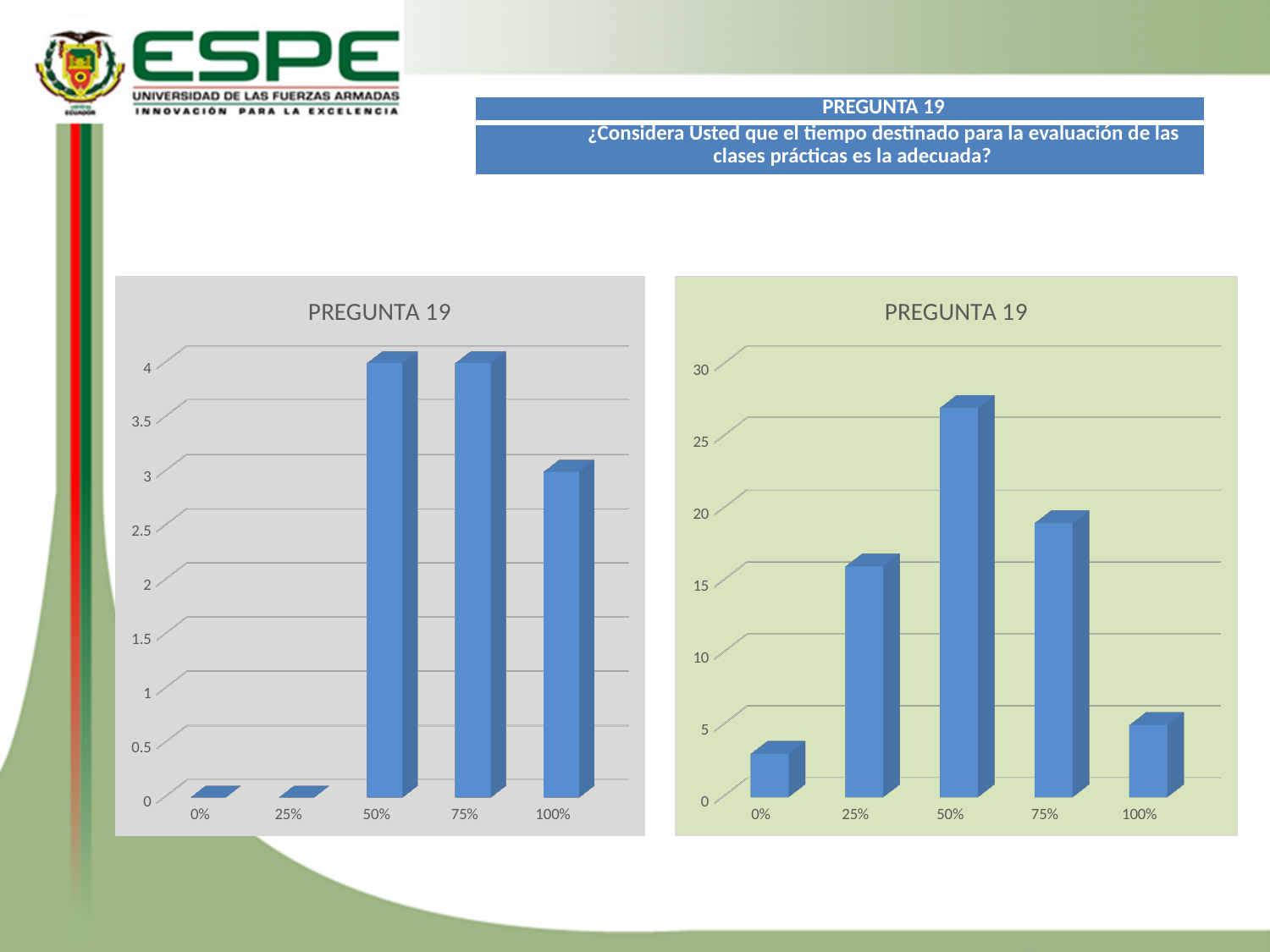
On the left chart, what is the value for 50%? 4 How many categories are shown on the x axis of the right chart? 5 On the left chart, what is the value for 100%? 3 On the left chart, which is larger, the value for 50% or the value for 100%? 50% On the right chart, which category has the highest value? 50% On the right chart, is the value for 50% greater or less than 25? greater On the left chart, what is the difference between the values for 75% and 100%? 1 On the left chart, what is the value for 0%? 0 On the right chart, which category has the lowest value? 0% What kind of chart is the left chart? bar chart